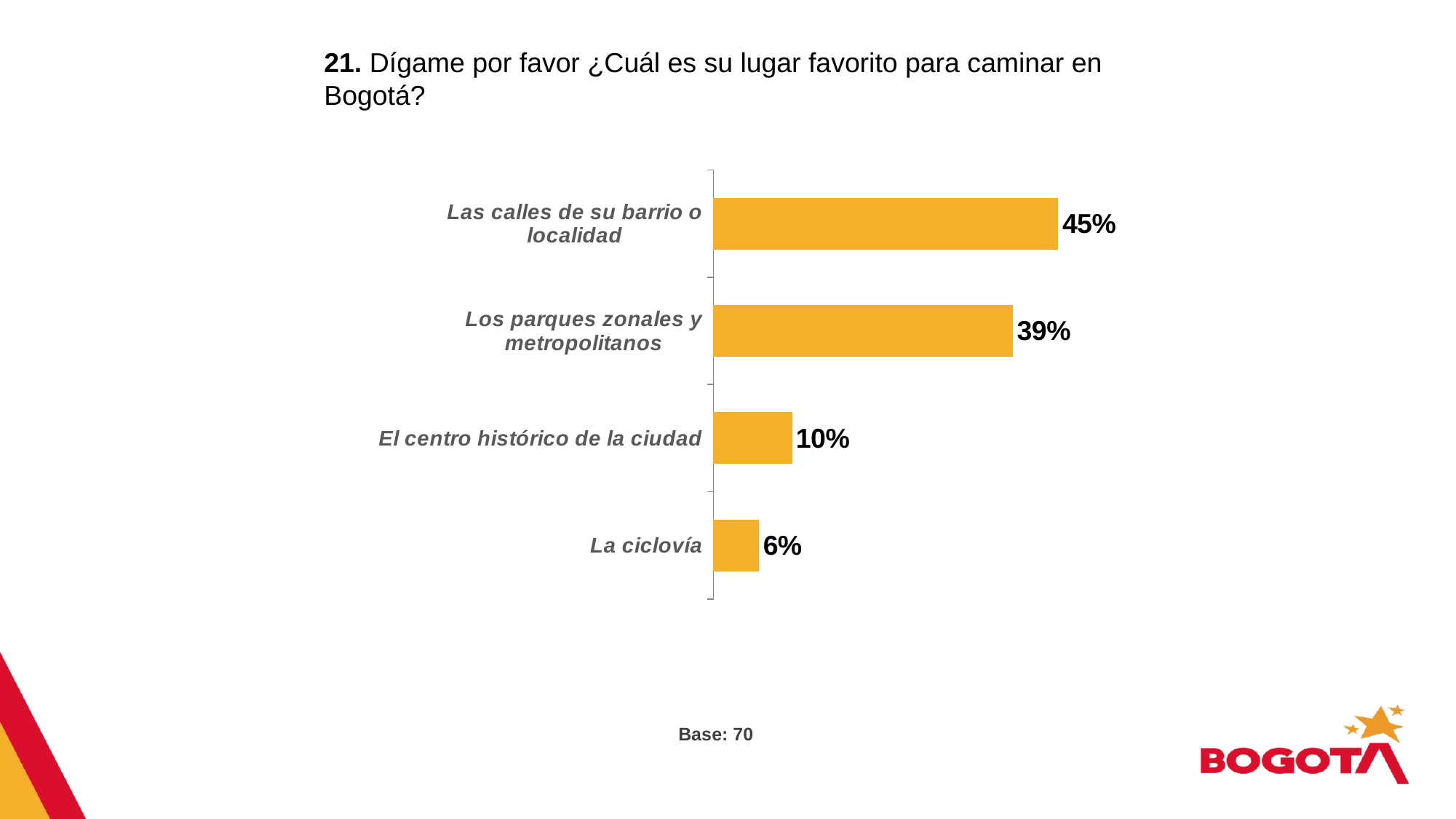
Which category has the lowest value? La ciclovía What type of chart is shown on the slide? Bar chart What is the base (number of respondents) noted below the chart? 70 What is the difference between 'El centro histórico de la ciudad' and 'La ciclovía'? 4% What is the value for 'La ciclovía'? 6% What percentage is shown for 'El centro histórico de la ciudad'? 10% Which category has the highest value? Las calles de su barrio o localidad What is the value shown for 'Los parques zonales y metropolitanos'? 39% What is the difference between the values for 'Las calles de su barrio o localidad' and 'Los parques zonales y metropolitanos'? 6% Which is larger: the value for 'El centro histórico de la ciudad' or 'La ciclovía'? El centro histórico de la ciudad What percentage of respondents chose 'Las calles de su barrio o localidad' as their favorite place to walk? 45% How many categories are shown in the chart? 4